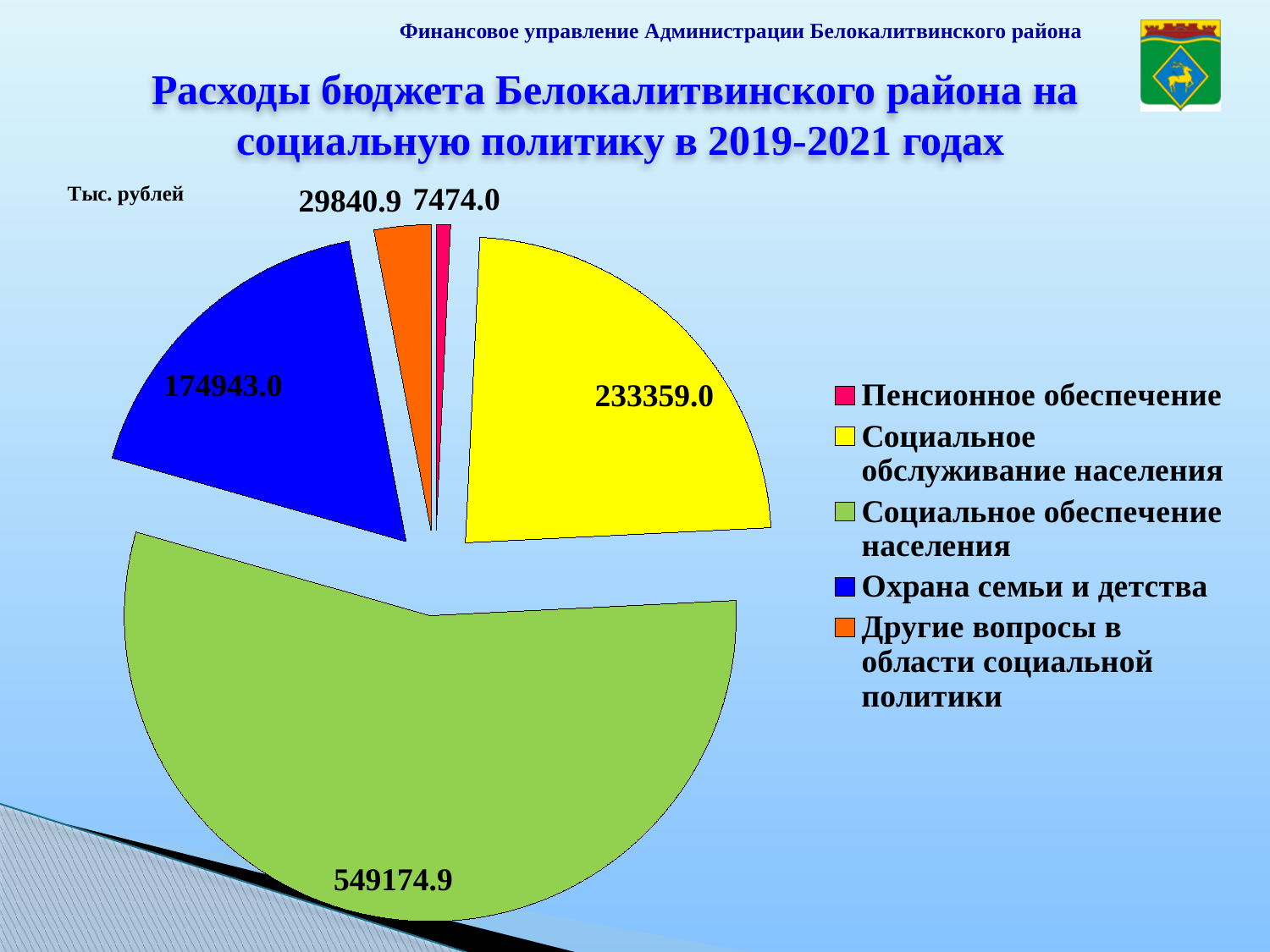
What is the value for Социальное обеспечение населения? 549174.9 What is the difference between the values for Социальное обслуживание населения and Охрана семьи и детства? 58416.0 Which category has the smallest slice of the pie? Пенсионное обеспечение How many slices does the pie chart have? 5 What is the value for Охрана семьи и детства? 174943.0 Which is larger: the value for Другие вопросы в области социальной политики or the value for Пенсионное обеспечение? Другие вопросы в области социальной политики What is the value for Другие вопросы в области социальной политики? 29840.9 What is the value for Социальное обслуживание населения? 233359.0 Which category has the largest slice of the pie? Социальное обеспечение населения What unit of measurement is indicated for the values on the chart? Тыс. рублей What kind of chart is shown on the slide? pie chart What is the value for Пенсионное обеспечение? 7474.0